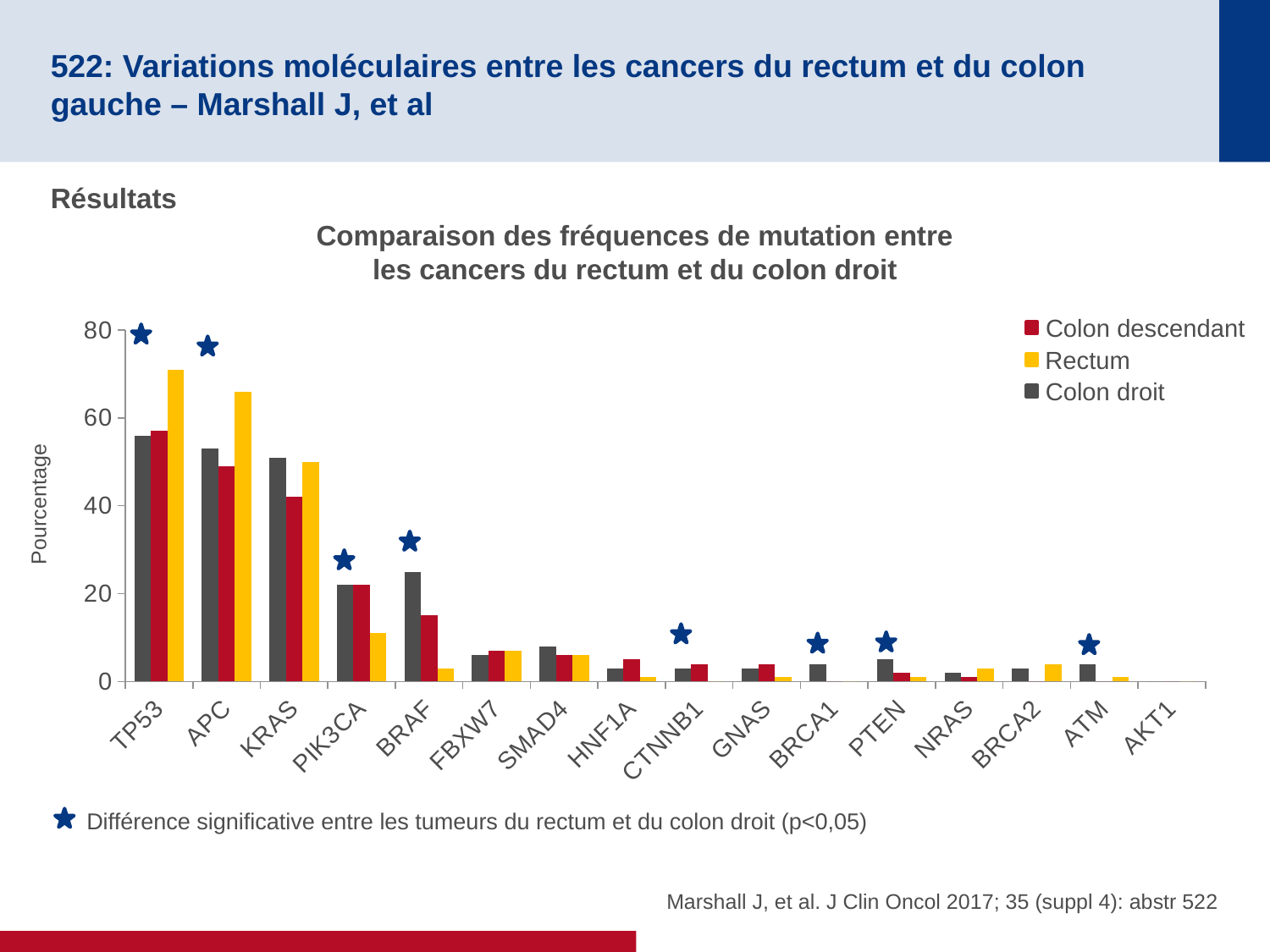
For BRAF, which series has the highest value? Colon droit What is the label of the y axis? Pourcentage How many series does the legend list? 3 Do the mutation frequencies generally rise or fall from left to right along the x axis? fall Is the Colon droit value for BRAF greater or less than 20? greater Is the Rectum value for TP53 greater or less than 60? greater How many genes are shown along the x axis? 16 For APC, which is larger: the Rectum value or the Colon descendant value? Rectum What kind of chart is shown on the slide? bar chart For TP53, which series has the highest value? Rectum Is the Rectum value for BRAF greater or less than 20? less Which gene has the highest Rectum mutation frequency? TP53